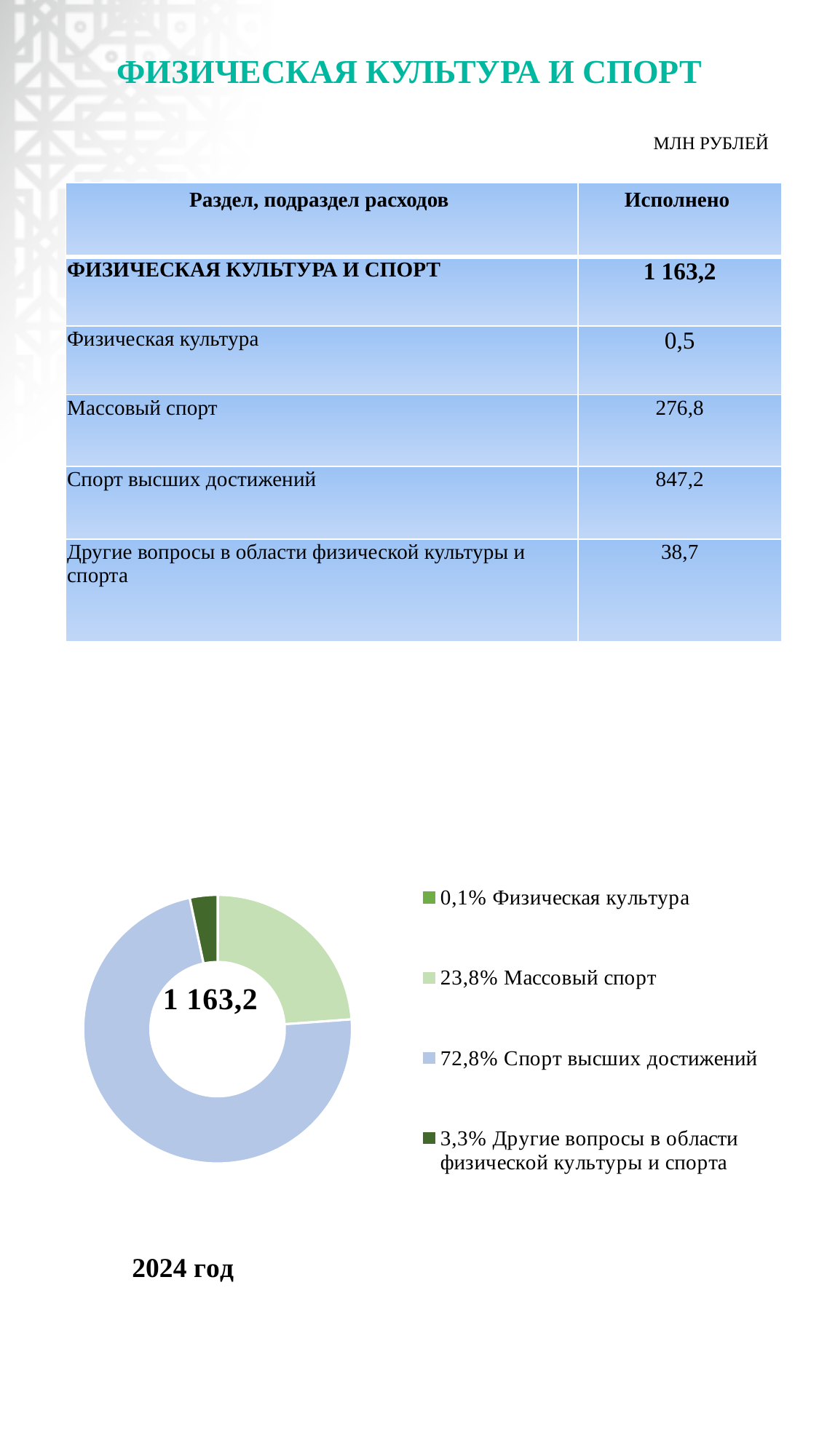
How many categories does the legend of the doughnut chart list? 4 Which category has the smallest slice in the doughnut chart? Физическая культура What kind of chart is shown at the bottom of the slide? Doughnut (pie) chart What total value is printed in the centre of the doughnut chart? 1 163,2 What share of the doughnut chart does Спорт высших достижений take? 72,8% What is the difference in percentage points between the shares of Спорт высших достижений and Массовый спорт in the doughnut chart? 49,0% What share of the doughnut chart does Массовый спорт take? 23,8% Which category has the largest slice in the doughnut chart? Спорт высших достижений What year is labelled below the doughnut chart? 2024 год What share of the doughnut chart does Другие вопросы в области физической культуры и спорта take? 3,3% Which slice is larger in the doughnut chart: Массовый спорт or Другие вопросы в области физической культуры и спорта? Массовый спорт